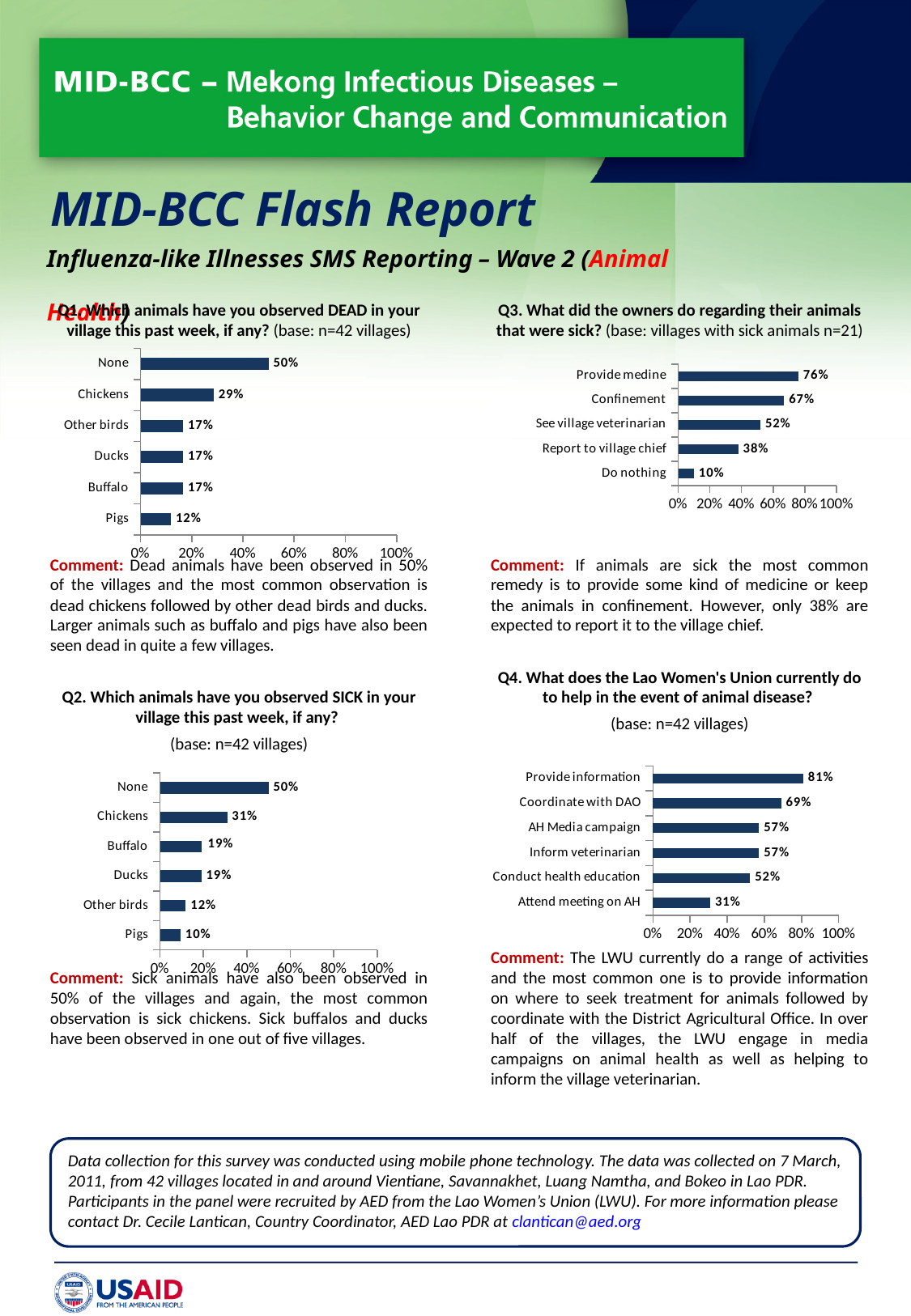
In the Q4 chart (Lao Women's Union activities), what percentage is shown for Coordinate with DAO? 69% In the Q2 chart (animals observed SICK), which is larger, the value for Ducks or the value for Other birds? Ducks In the Q3 chart (what owners did regarding sick animals), which category has the highest value? Provide medine In the Q1 chart (animals observed DEAD), how many categories are plotted? 6 In the Q1 chart (animals observed DEAD), what percentage is shown for Chickens? 29% In the Q2 chart (animals observed SICK), what is the difference between the values for Chickens and Pigs? 21% In the Q1 chart (animals observed DEAD), which category has the lowest value? Pigs In the Q2 chart (animals observed SICK), what percentage is shown for Buffalo? 19% In the Q3 chart (what owners did regarding sick animals), what is the difference between Confinement and Do nothing? 57% In the Q3 chart (what owners did regarding sick animals), what percentage is shown for Report to village chief? 38% What type of chart is the Q4 chart (Lao Women's Union activities)? Bar chart In the Q4 chart (Lao Women's Union activities), which category has the lowest value? Attend meeting on AH